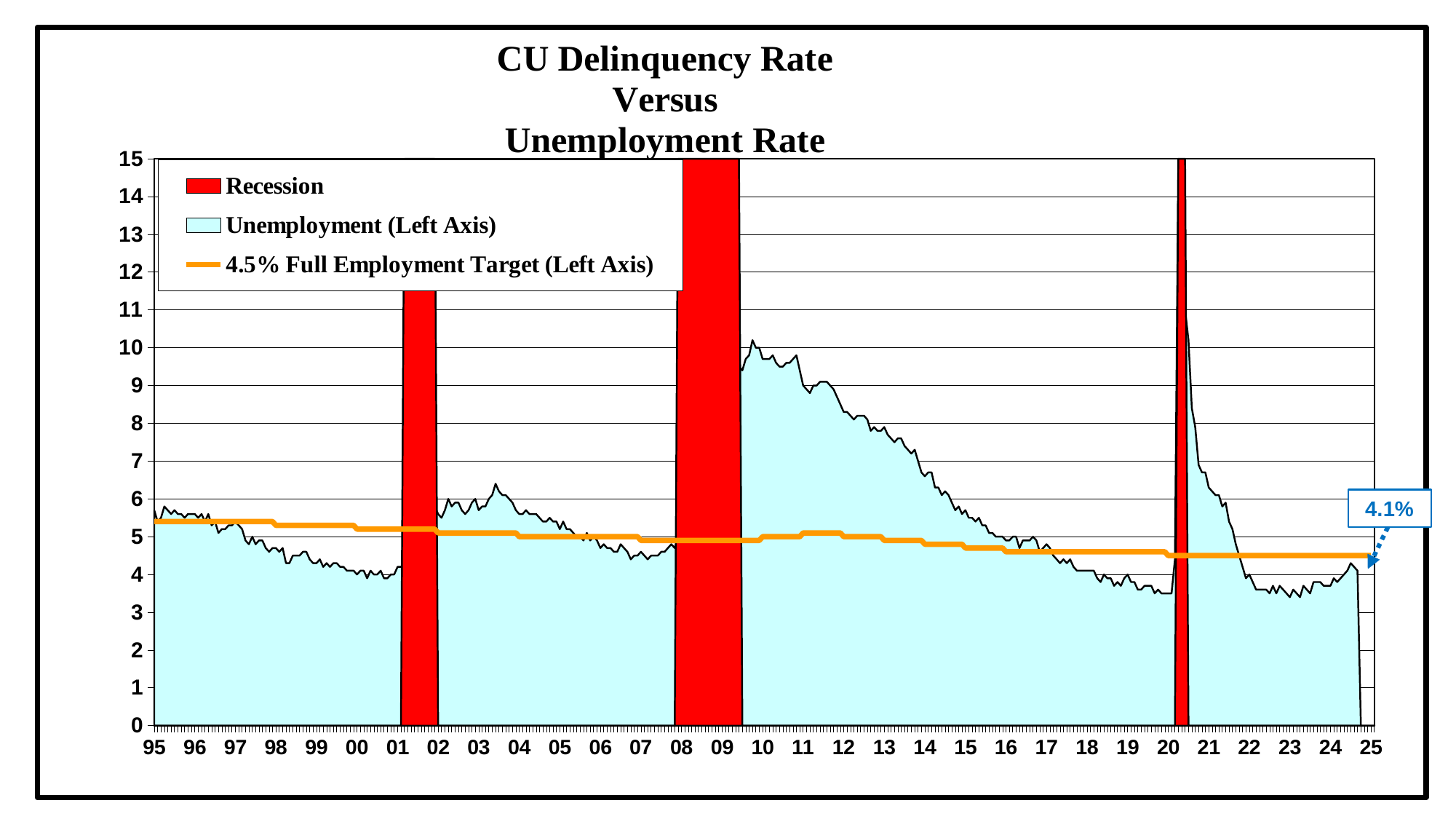
What is the most recent unemployment rate value labeled on the chart? 4.1% What is the title of the chart? CU Delinquency Rate Versus Unemployment Rate How many series does the legend list? 3 How many recession periods are shaded on the chart? 3 Is the unemployment rate in 2010 greater or less than 9? greater What full employment target does the orange line represent? 4.5% What kind of chart is this? area and line chart What is the legend label for the orange line? 4.5% Full Employment Target (Left Axis) Does the unemployment rate rise or fall from 2010 to 2019? fall Is the unemployment rate in 2000 greater or less than 5? less Is the unemployment rate in 2003 greater or less than 5? greater